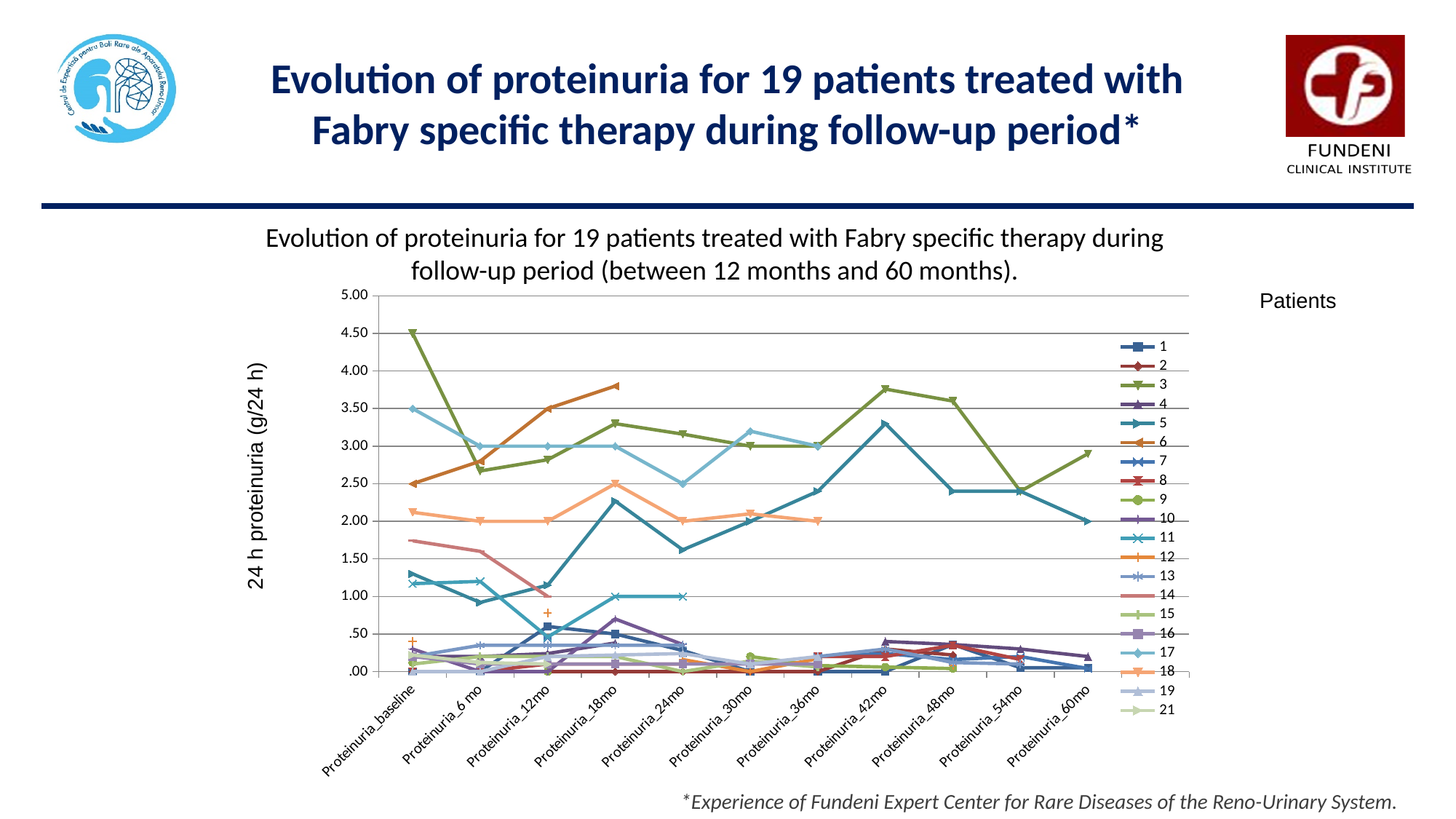
What is the title shown above the legend? Patients What is the label of the y axis? 24 h proteinuria (g/24 h) Does the value for patient 3 rise or fall from Proteinuria_baseline to Proteinuria_6 mo? fall Is the value for patient 14 at Proteinuria_baseline greater or less than 1.50? greater Is the value for patient 6 at Proteinuria_18mo greater or less than 3.50? greater Is the value for patient 3 at Proteinuria_42mo greater or less than 3.50? greater What kind of chart is shown on the slide? line chart Which is larger at Proteinuria_baseline, the value for patient 3 or patient 17? patient 3 How many series does the legend list? 20 How many time points are shown along the x axis? 11 Which patient has the highest proteinuria at Proteinuria_baseline? 3